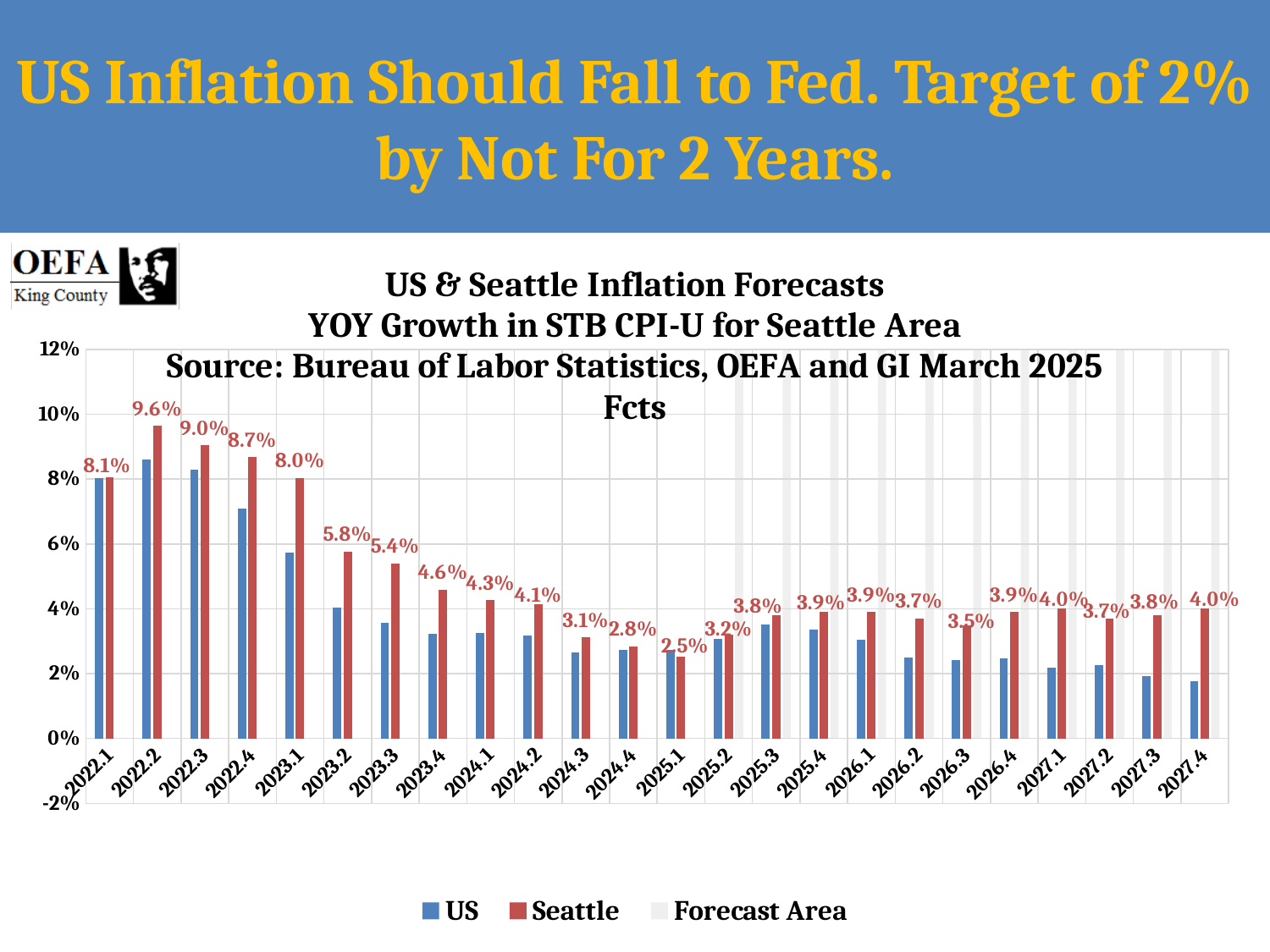
Which is larger, the Seattle value for 2023.2 or for 2024.2? 2023.2 How many quarters are shown on the x axis? 24 Is the US value for 2027.4 greater or less than 2%? less Is the US value for 2022.2 greater or less than 8%? greater How many entries does the legend list? 3 What is the Seattle inflation value for 2027.4? 4.0% What is the difference between the Seattle values for 2022.2 and 2025.1? 7.1% What is the Seattle inflation value for 2025.1? 2.5% In which quarter is the Seattle inflation value highest? 2022.2 What is the Seattle inflation value for 2022.2? 9.6% What kind of chart is shown on the slide? Bar chart In which quarter is the Seattle inflation value lowest? 2025.1